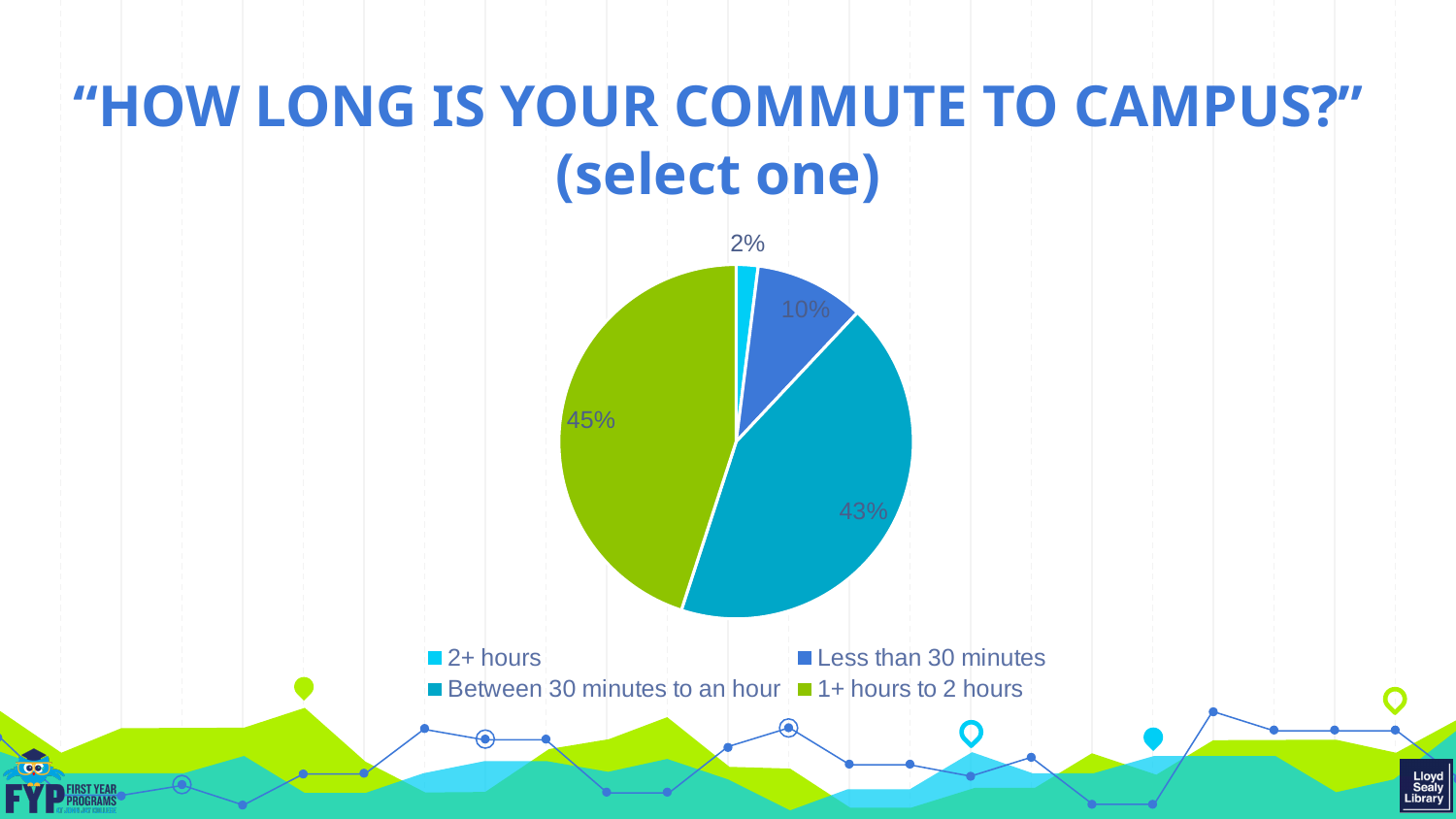
What percentage of respondents have a commute of less than 30 minutes? 10% Which commute length has the largest share of the pie? 1+ hours to 2 hours What is the difference in percentage points between the 'Less than 30 minutes' slice and the '2+ hours' slice? 8 Which is larger: the share for 'Less than 30 minutes' or the share for '2+ hours'? Less than 30 minutes What is the title of the chart on the slide? "HOW LONG IS YOUR COMMUTE TO CAMPUS?" (select one) What is the difference in percentage points between the '1+ hours to 2 hours' slice and the 'Between 30 minutes to an hour' slice? 2 How many categories does the pie chart have? 4 What kind of chart is shown on the slide? Pie chart What percentage of respondents have a commute of 2+ hours? 2% What percentage of respondents have a commute of 1+ hours to 2 hours? 45% What percentage of respondents have a commute of between 30 minutes to an hour? 43% Which commute length has the smallest share of the pie? 2+ hours